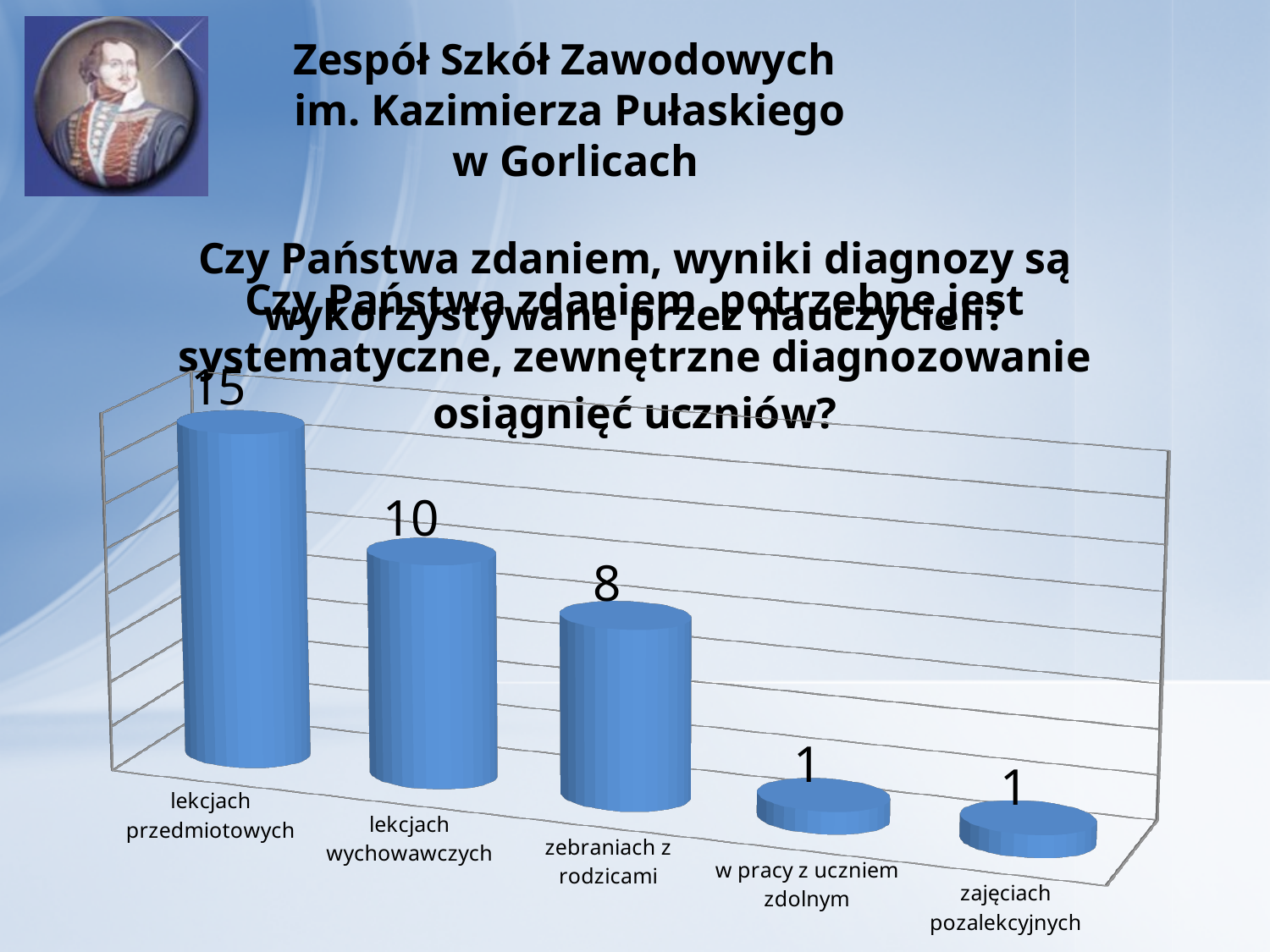
What is the value for "lekcjach przedmiotowych"? 15 What is the value for "lekcjach wychowawczych"? 10 What is the value for "zajęciach pozalekcyjnych"? 1 What is the value for "w pracy z uczniem zdolnym"? 1 Which is larger, the value for "zebraniach z rodzicami" or the value for "w pracy z uczniem zdolnym"? zebraniach z rodzicami What is the value for "zebraniach z rodzicami"? 8 What kind of chart is shown on the slide? bar chart Which category has the highest value? lekcjach przedmiotowych Do the values rise or fall from left to right across the categories? fall What is the difference between the values for "lekcjach przedmiotowych" and "lekcjach wychowawczych"? 5 What is the difference between the values for "lekcjach wychowawczych" and "zebraniach z rodzicami"? 2 How many categories are shown in the chart? 5